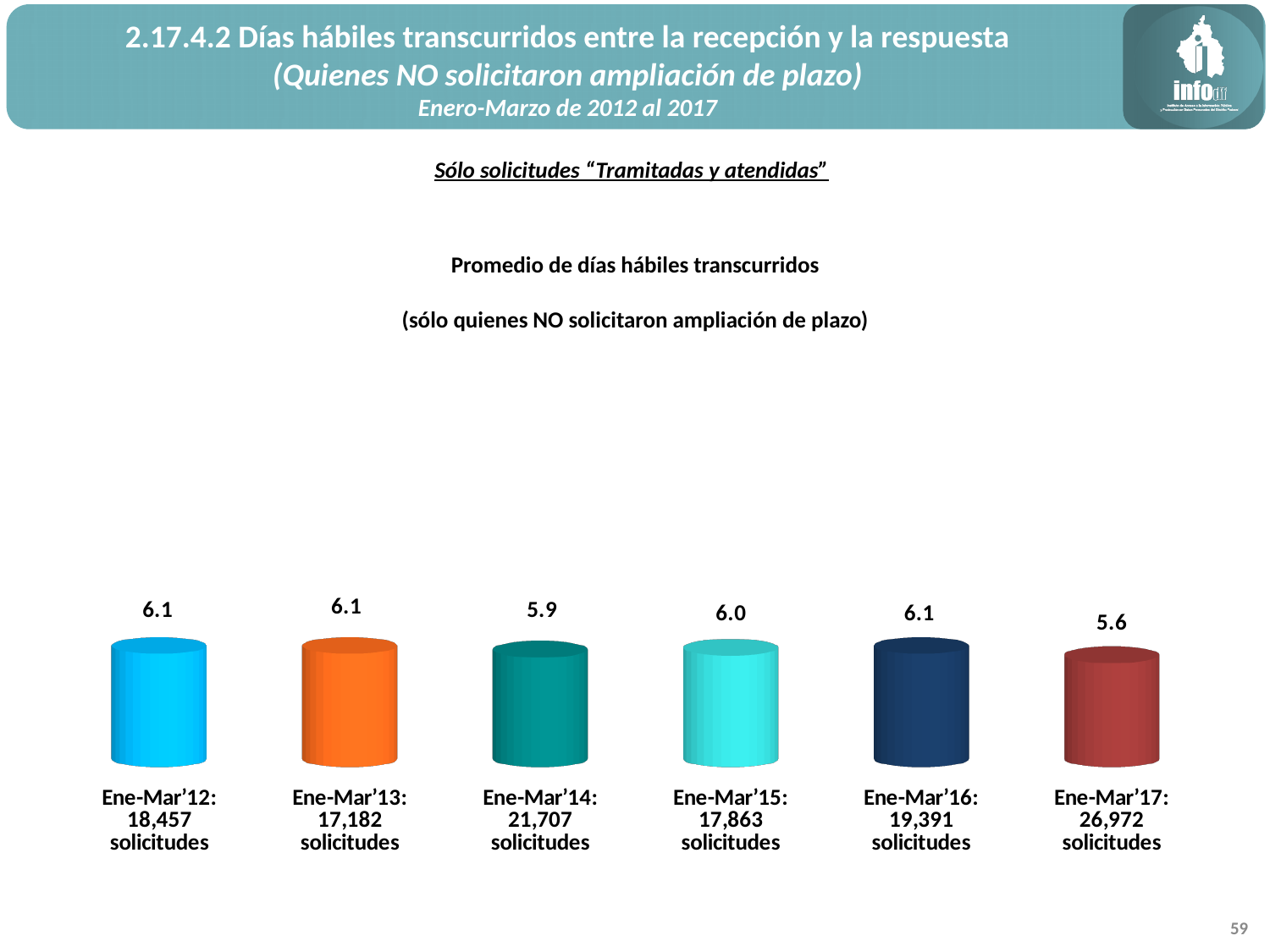
What is the average number of business days shown for Ene-Mar'12? 6.1 Which is larger, the value for Ene-Mar'14 or the value for Ene-Mar'17? Ene-Mar'14 What is the difference between the values for Ene-Mar'14 and Ene-Mar'17? 0.3 How many solicitudes are indicated in the label for Ene-Mar'17? 26,972 What kind of chart is shown on the slide? Bar chart Did the average number of business days rise or fall from Ene-Mar'16 to Ene-Mar'17? Fall What is the difference between the values for Ene-Mar'16 and Ene-Mar'17? 0.5 What is the average number of business days shown for Ene-Mar'15? 6.0 Which period has the lowest average number of business days? Ene-Mar'17 How many periods are plotted in the chart? 6 What is the average number of business days shown for Ene-Mar'14? 5.9 What is the average number of business days shown for Ene-Mar'17? 5.6